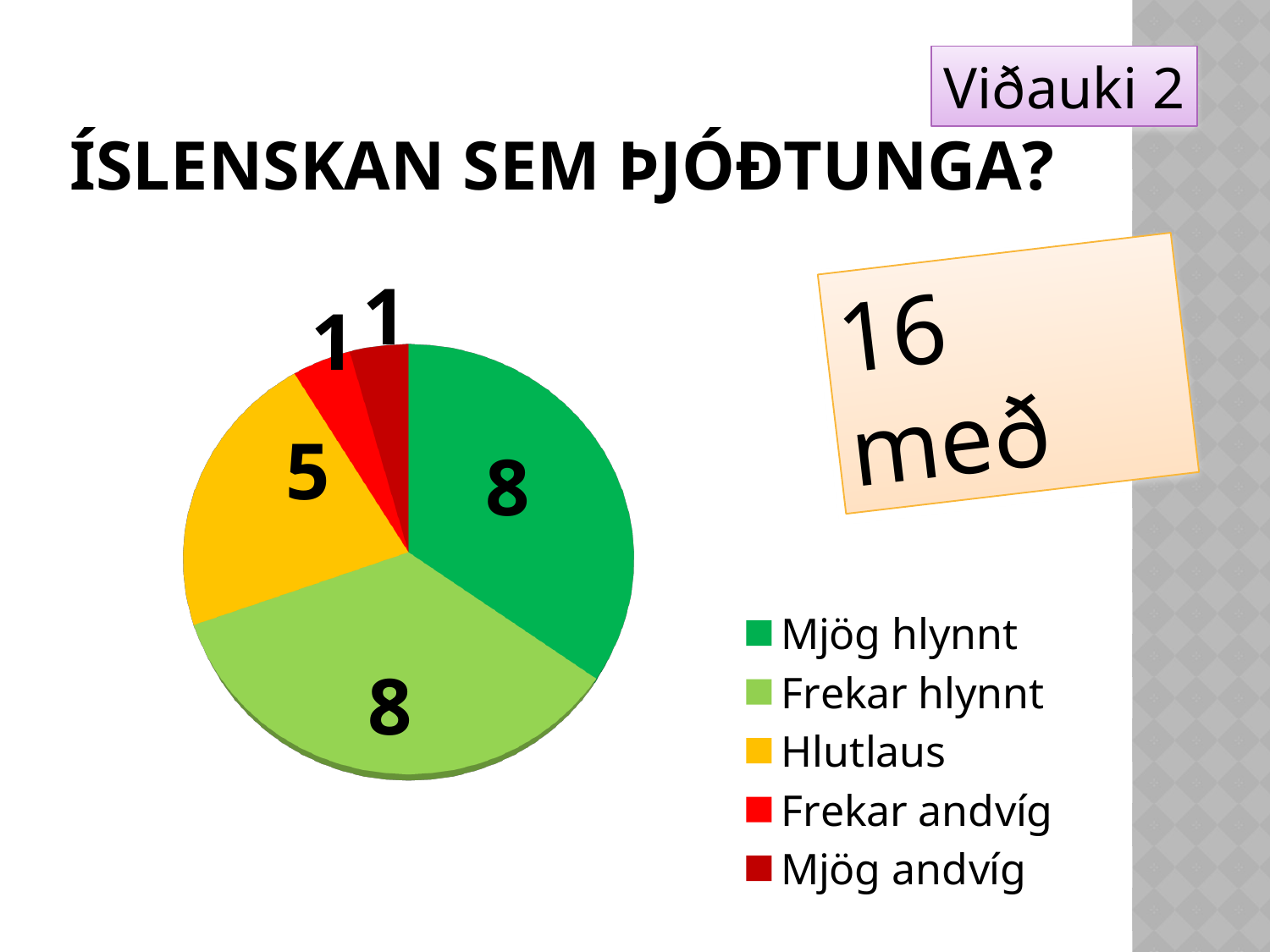
How many entries does the legend list? 5 What is the value for Mjög andvíg in the pie chart? 1 How many slices does the pie chart have? 5 What is the value for Hlutlaus in the pie chart? 5 What is the value for Frekar andvíg in the pie chart? 1 What is the difference between the value for Hlutlaus and the value for Frekar andvíg? 4 What is the value for Mjög hlynnt in the pie chart? 8 What is the difference between the value for Frekar hlynnt and the value for Hlutlaus? 3 What type of chart is shown on the slide? pie chart What is the value for Frekar hlynnt in the pie chart? 8 Which legend entry is shown in yellow? Hlutlaus Which is larger, the value for Mjög hlynnt or the value for Hlutlaus? Mjög hlynnt